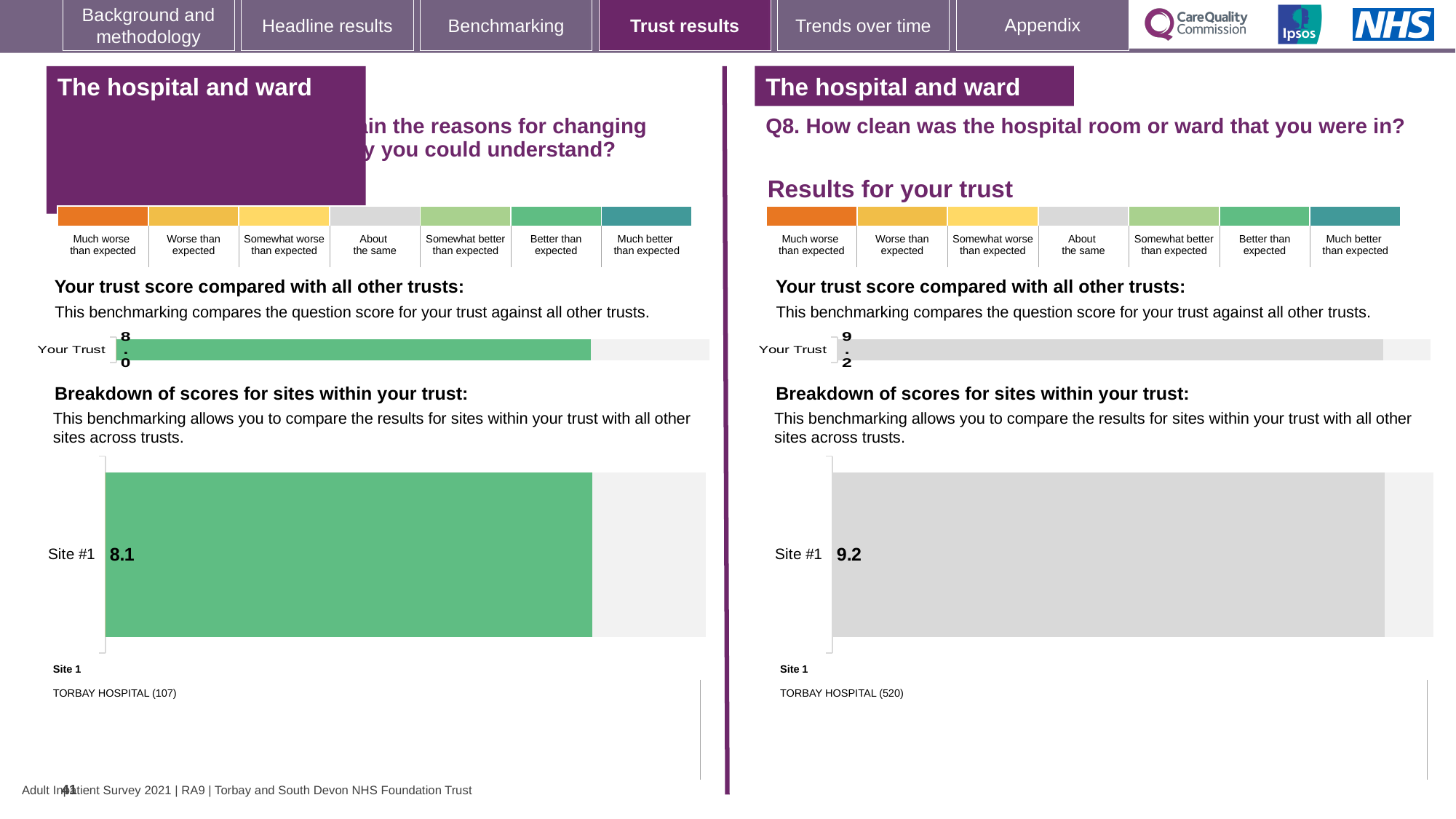
On the left half of the slide, in the 'Breakdown of scores for sites within your trust' chart, what is the score for Site #1? 8.1 On the right half of the slide (Q8, how clean was the hospital room or ward), what is the score shown for Your Trust? 9.2 On the right half of the slide (Q8), what is the difference between the Site #1 score and the Your Trust score? 0 What colour is the Site #1 bar in the breakdown chart on the right half of the slide (Q8)? Grey On the right half of the slide (Q8), in the breakdown of scores for sites chart, what is the score for Site #1? 9.2 On the left half of the slide, what is the difference between the Site #1 score and the Your Trust score? 0.1 What colour is the Site #1 bar in the breakdown chart on the left half of the slide? Green How many sites are shown in the 'Breakdown of scores for sites within your trust' chart on the left half of the slide? 1 Which Site #1 score is larger: the one in the left-hand breakdown chart or the one in the right-hand Q8 breakdown chart? The right-hand Q8 chart (9.2) What kind of chart is used to show the Site #1 score on the right half of the slide (Q8)? Bar chart On the left half of the slide, in the 'Your trust score compared with all other trusts' chart, what is the score shown for Your Trust? 8.0